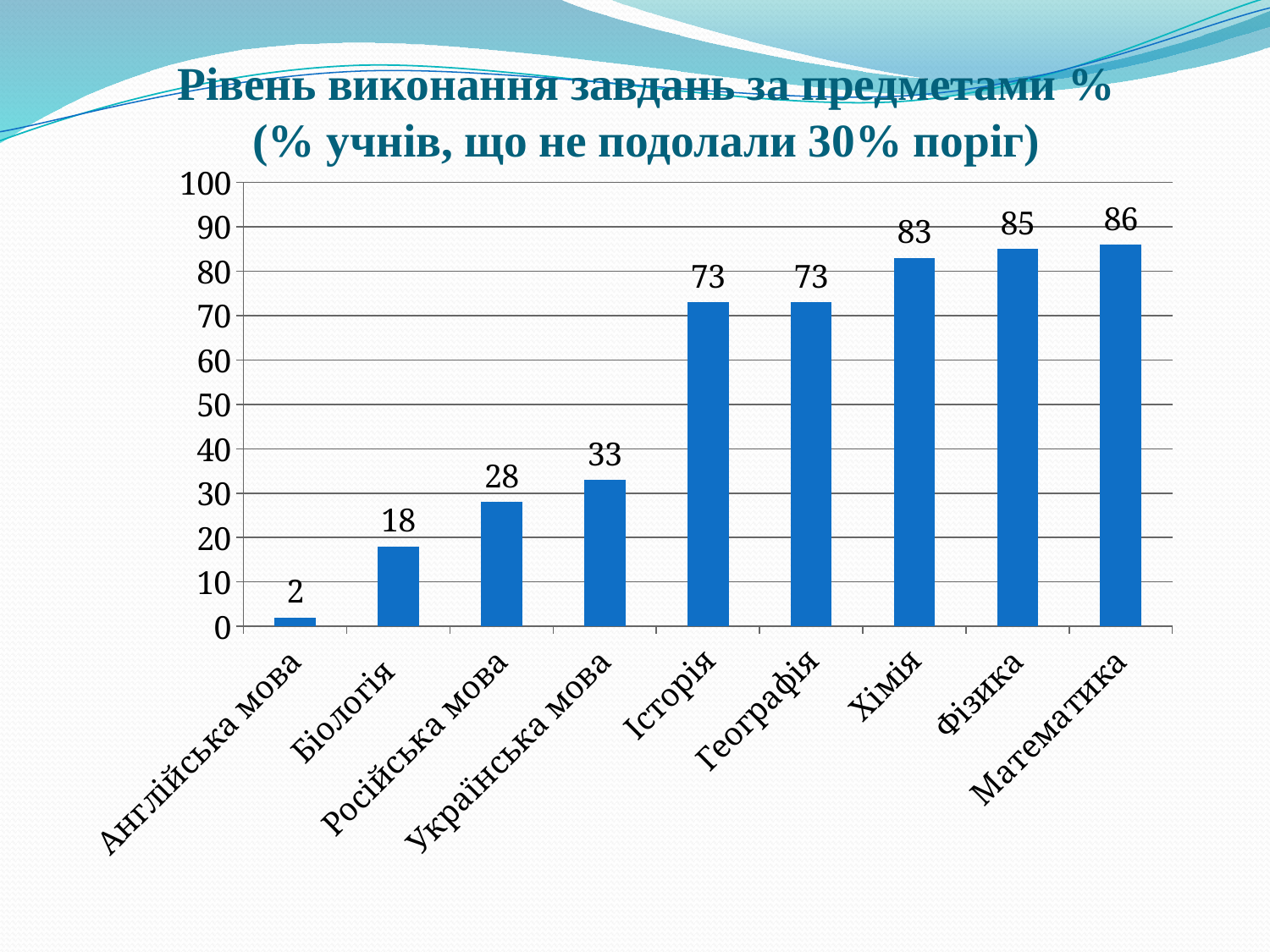
What is the value for Математика? 86 Which subject has the highest value? Математика Which subject has the lowest value? Англійська мова What is the value for Біологія? 18 What kind of chart is shown on the slide? bar chart What is the title of the chart? Рівень виконання завдань за предметами % (% учнів, що не подолали 30% поріг) Which is larger, the value for Фізика or the value for Історія? Фізика How many subjects are shown on the chart? 9 What is the difference between the values for Хімія and Російська мова? 55 Do the values rise or fall from left to right along the x axis? rise Is the value for Географія greater or less than 50? greater What is the value for Українська мова? 33